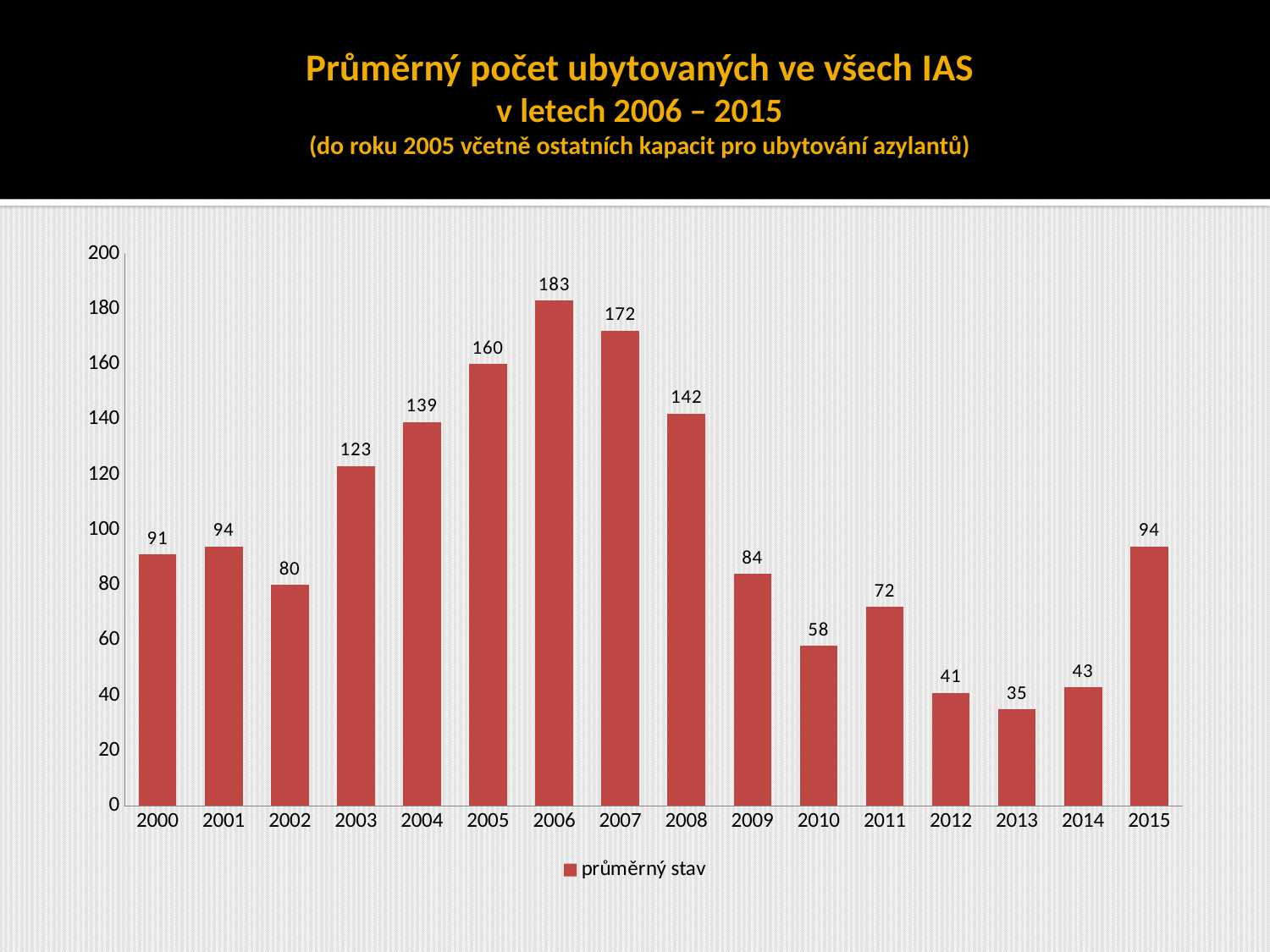
What is the difference between the values for 2008 and 2009? 58 Which year has the lowest value? 2013 What is the name of the series in the legend? průměrný stav What kind of chart is shown on the slide? bar chart What is the value for 2013? 35 How many years are shown on the x axis? 16 What is the difference between the values for 2006 and 2007? 11 What is the value for 2015? 94 How many series does the legend list? 1 Which is larger, the value for 2003 or the value for 2004? 2004 What is the value for 2006? 183 Which year has the highest value? 2006